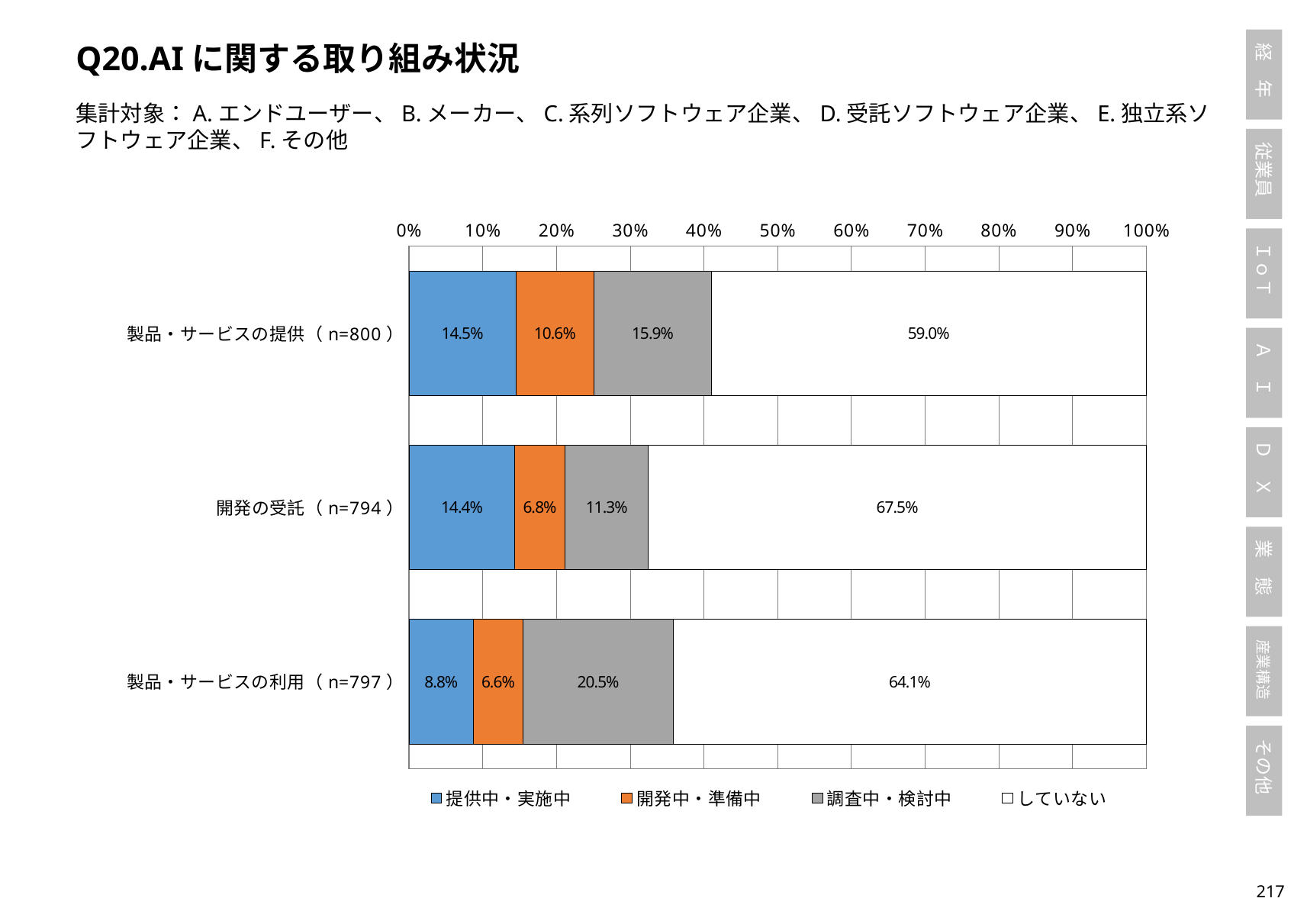
What kind of chart is shown on the slide? Stacked bar chart What is the value of 提供中・実施中 for 製品・サービスの提供 (n=800)? 14.5% What is the value of していない for 開発の受託 (n=794)? 67.5% Which is larger: 開発中・準備中 for 製品・サービスの提供 (n=800) or for 製品・サービスの利用 (n=797)? 製品・サービスの提供 (n=800) Which category has the lowest value for 提供中・実施中? 製品・サービスの利用 (n=797) Which category has the highest value for していない? 開発の受託 (n=794) What colour represents 調査中・検討中 in the chart? Gray What is the value of 調査中・検討中 for 製品・サービスの利用 (n=797)? 20.5% How many categories are shown on the chart? 3 What is the value of 開発中・準備中 for 開発の受託 (n=794)? 6.8% What is the difference between the 調査中・検討中 values for 製品・サービスの利用 (n=797) and 開発の受託 (n=794)? 9.2% How many series does the legend list? 4